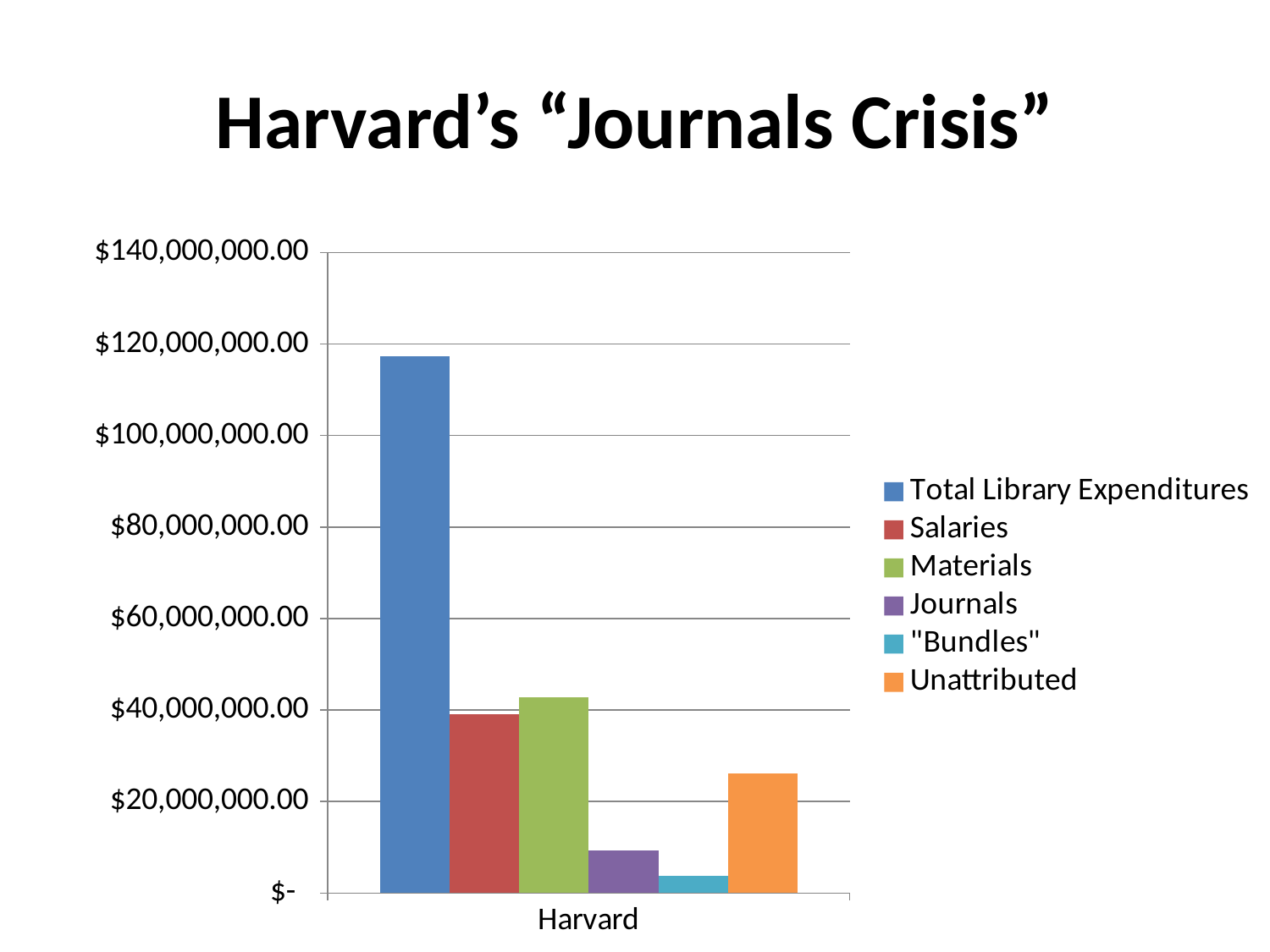
Is the value for Total Library Expenditures greater or less than $120,000,000.00? less Which series has the highest value? Total Library Expenditures Is the value for Total Library Expenditures greater or less than $100,000,000.00? greater Is the value for Materials greater or less than $40,000,000.00? greater What kind of chart is shown on the slide? bar chart Which series has the lowest value? "Bundles" What is the title of the slide? Harvard's "Journals Crisis" Which is larger, the value for Materials or the value for Salaries? Materials How many series does the legend list? 6